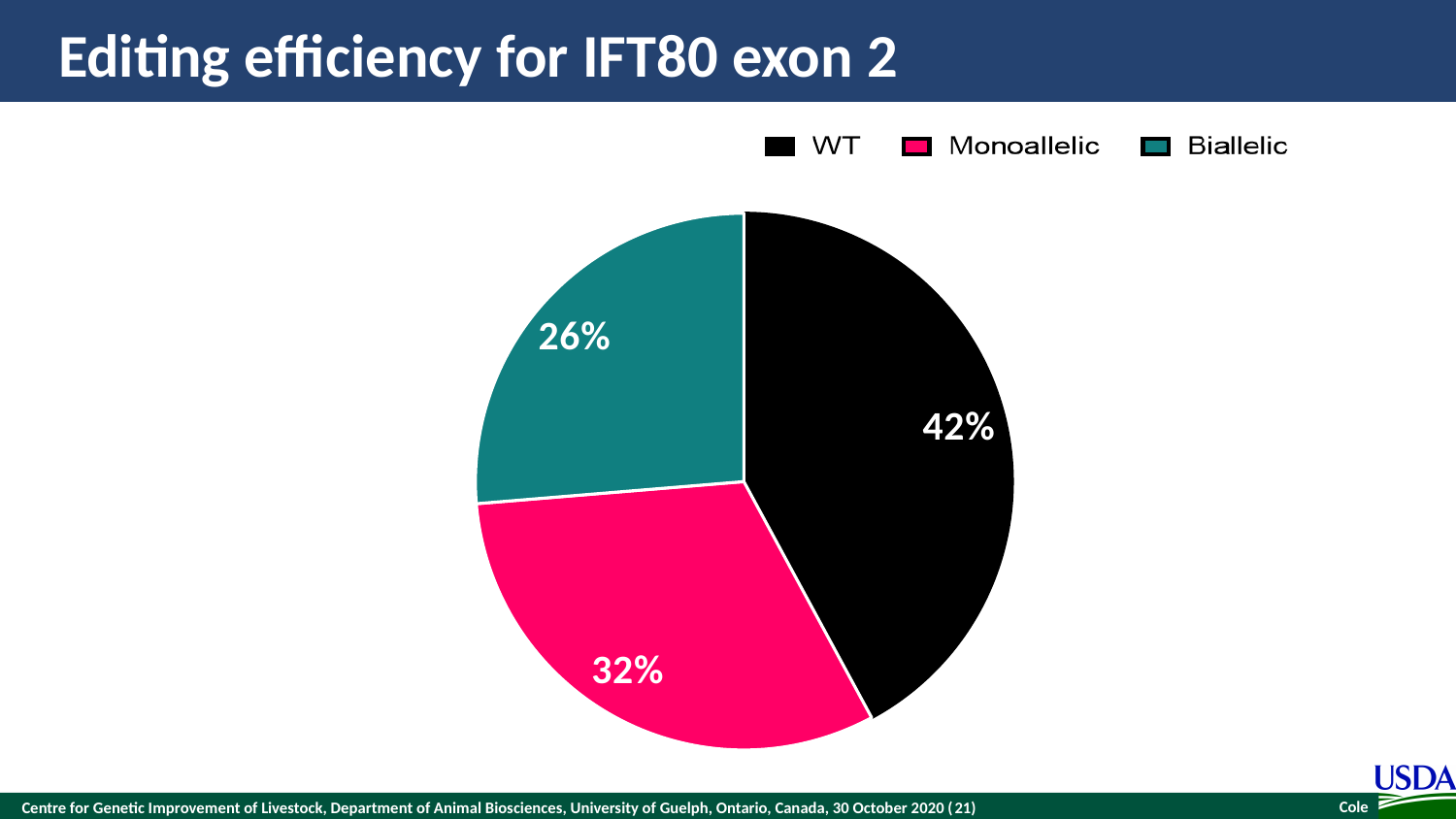
What is the difference in percentage points between the WT and Biallelic slices? 16 What share of the pie does the Biallelic slice represent? 26% Which category has the largest slice of the pie? WT What colour is the Monoallelic slice? pink Which category has the smallest slice of the pie? Biallelic What share of the pie does the Monoallelic slice represent? 32% How many entries does the legend list? 3 What share of the pie does the WT slice represent? 42% What is the difference in percentage points between the Monoallelic and Biallelic slices? 6 How many slices does the pie chart have? 3 Which is larger, the Monoallelic slice or the Biallelic slice? Monoallelic What kind of chart is shown on the slide? pie chart